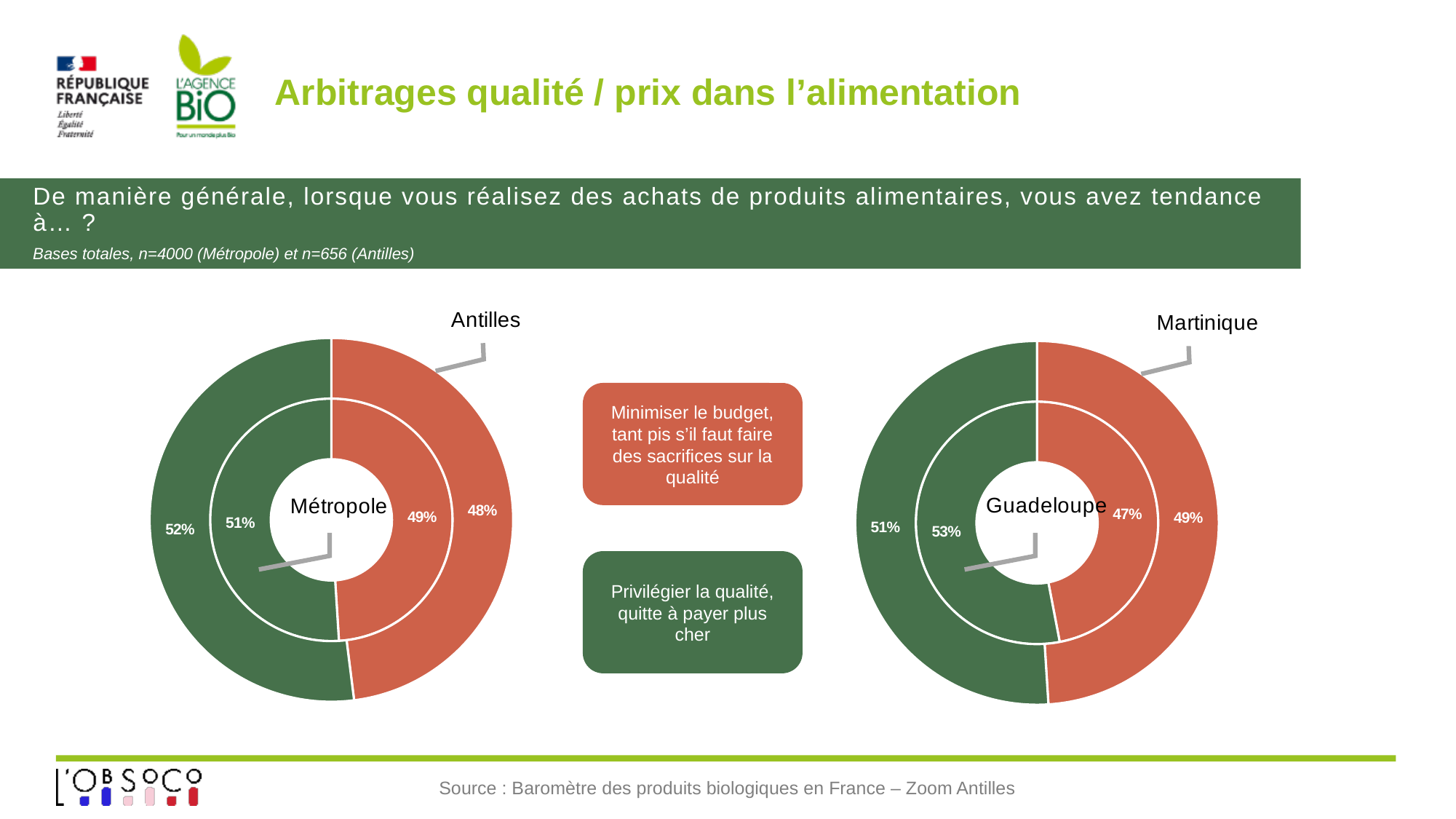
On the right chart, what share of Martinique respondents chose 'Minimiser le budget, tant pis s'il faut faire des sacrifices sur la qualité'? 49% On the right chart, which has the larger 'Minimiser le budget' share, Guadeloupe or Martinique? Martinique On the right chart, what share of Guadeloupe respondents chose 'Privilégier la qualité, quitte à payer plus cher'? 53% On the right chart, what share of Guadeloupe respondents chose 'Minimiser le budget'? 47% On the left chart, what is the difference between the 'Privilégier la qualité' share for Antilles and for Métropole? 1 percentage point On the left chart, what share of Métropole respondents chose 'Minimiser le budget, tant pis s'il faut faire des sacrifices sur la qualité'? 49% On the left chart, which has the larger 'Privilégier la qualité' share, Métropole or Antilles? Antilles Which colour represents 'Privilégier la qualité, quitte à payer plus cher' in the charts? Green On the left chart, what share of Antilles respondents chose 'Privilégier la qualité, quitte à payer plus cher'? 52% On the right chart, what is the difference between the 'Privilégier la qualité' share for Guadeloupe and for Martinique? 2 percentage points What type of chart is used on this slide? Doughnut chart How many response options are shown in the legend boxes between the two charts? 2